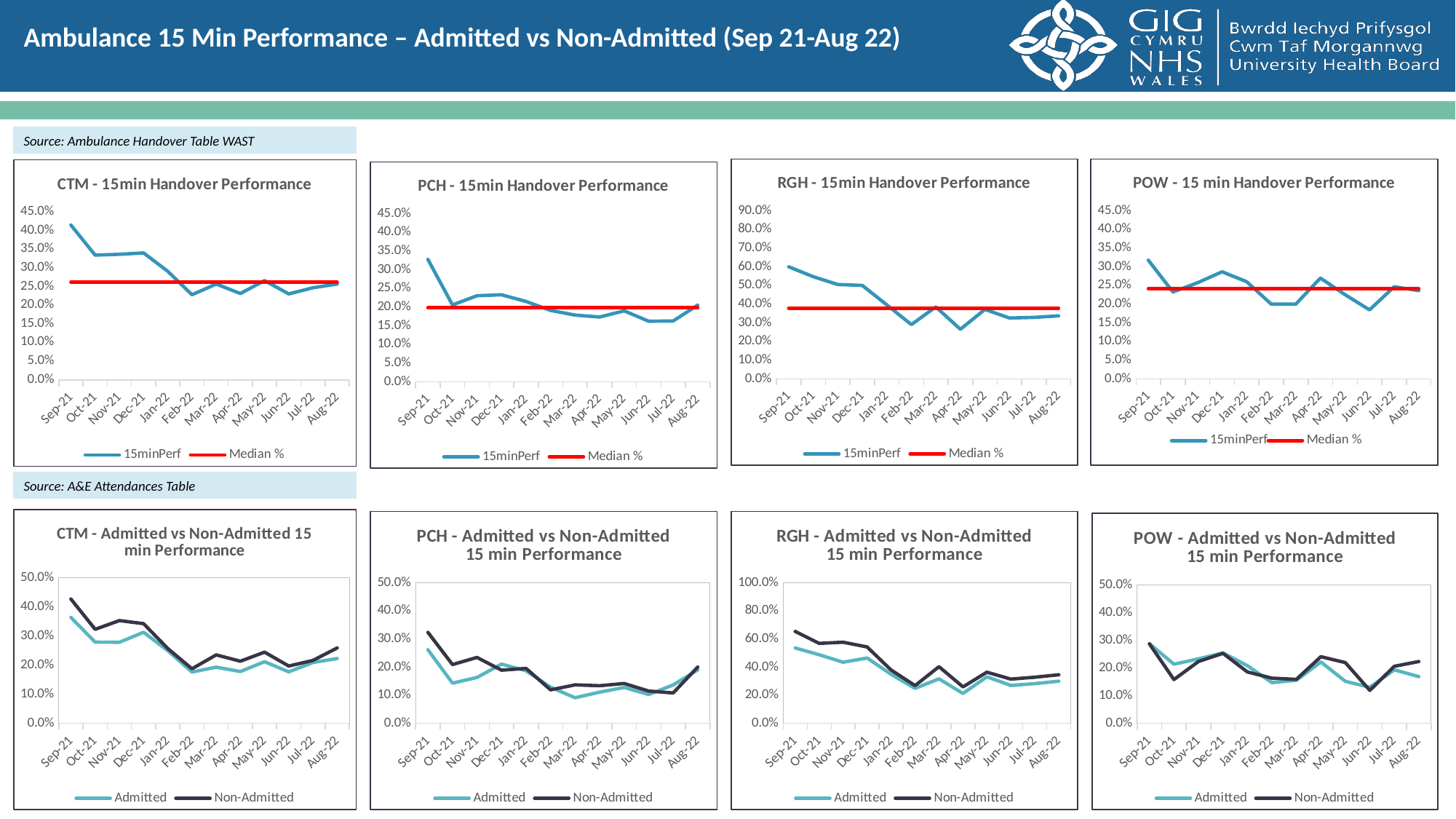
In 'RGH - 15min Handover Performance', is the 15minPerf value for Sep-21 greater or less than 50.0%? Greater In 'CTM - 15min Handover Performance', does the 15minPerf line generally rise or fall from Sep-21 to Aug-22? Fall How many series does the legend list in 'RGH - 15min Handover Performance'? 2 How many charts are shown on the slide? 8 What source is given for the top row of charts? Ambulance Handover Table WAST What kind of chart is 'CTM - 15min Handover Performance'? Line chart What colour is the Median % line in the 'PCH - 15min Handover Performance' chart? Red In 'CTM - 15min Handover Performance', which month has the highest 15minPerf value? Sep-21 In 'PCH - Admitted vs Non-Admitted 15 min Performance', is the Admitted value for Sep-21 greater or less than 20.0%? Greater In 'CTM - Admitted vs Non-Admitted 15 min Performance', which series has the higher value in Sep-21, Admitted or Non-Admitted? Non-Admitted In 'POW - 15 min Handover Performance', is the 15minPerf value for Sep-21 greater or less than 25.0%? Greater How many months are plotted on the x axis of the 'PCH - 15min Handover Performance' chart? 12